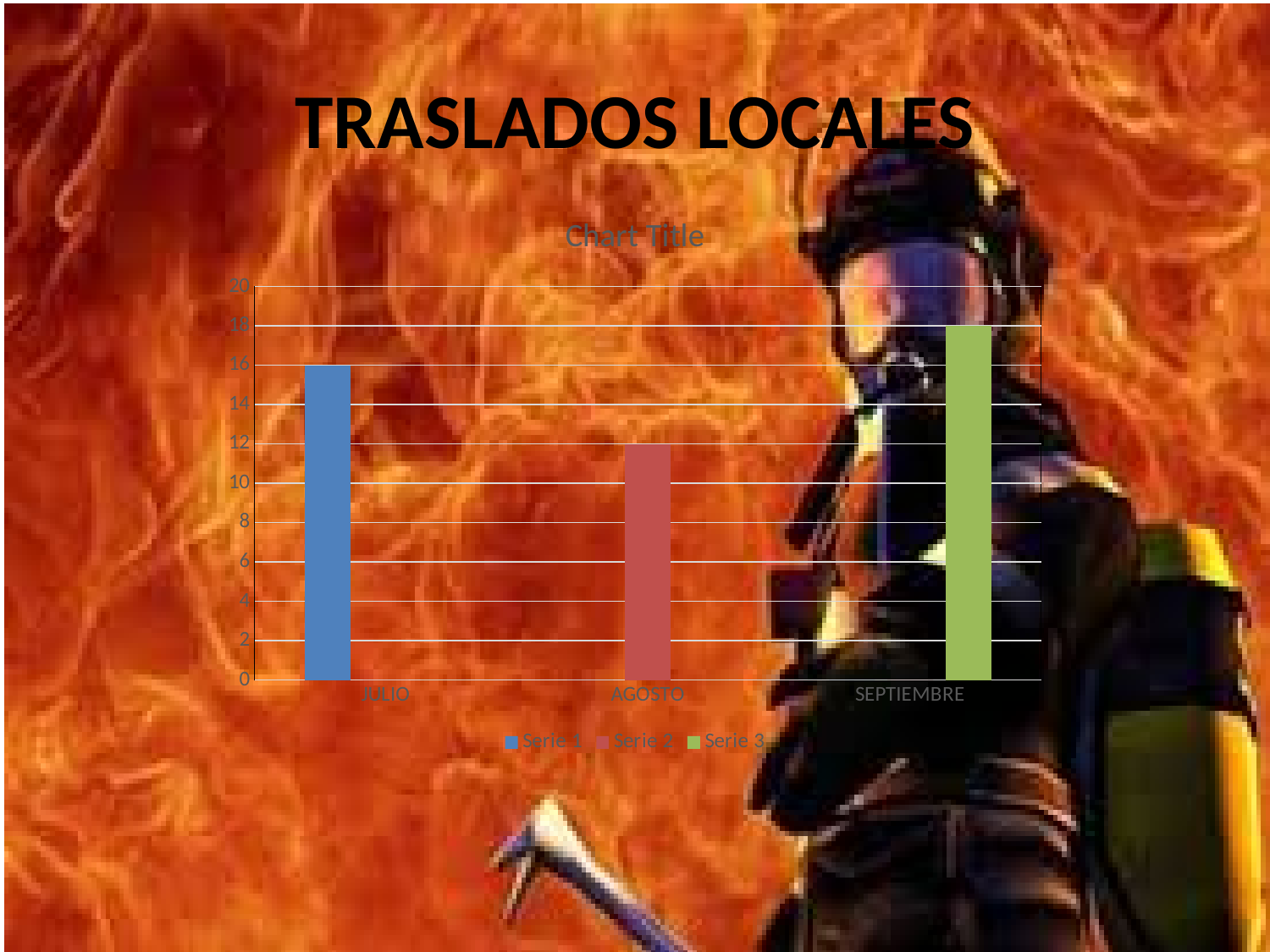
Which month has the lowest value? AGOSTO What type of chart is shown on the slide? bar chart What is the title shown above the chart? Chart Title How many categories are shown on the x axis of the chart? 3 Is the value for AGOSTO greater or less than 14? less How many series does the chart legend list? 3 Which month has the highest value? SEPTIEMBRE Which is larger, the value for JULIO or the value for AGOSTO? JULIO What is the value for JULIO? 16 What is the difference between the values for SEPTIEMBRE and AGOSTO? 6 What is the value for SEPTIEMBRE? 18 What is the value for AGOSTO? 12